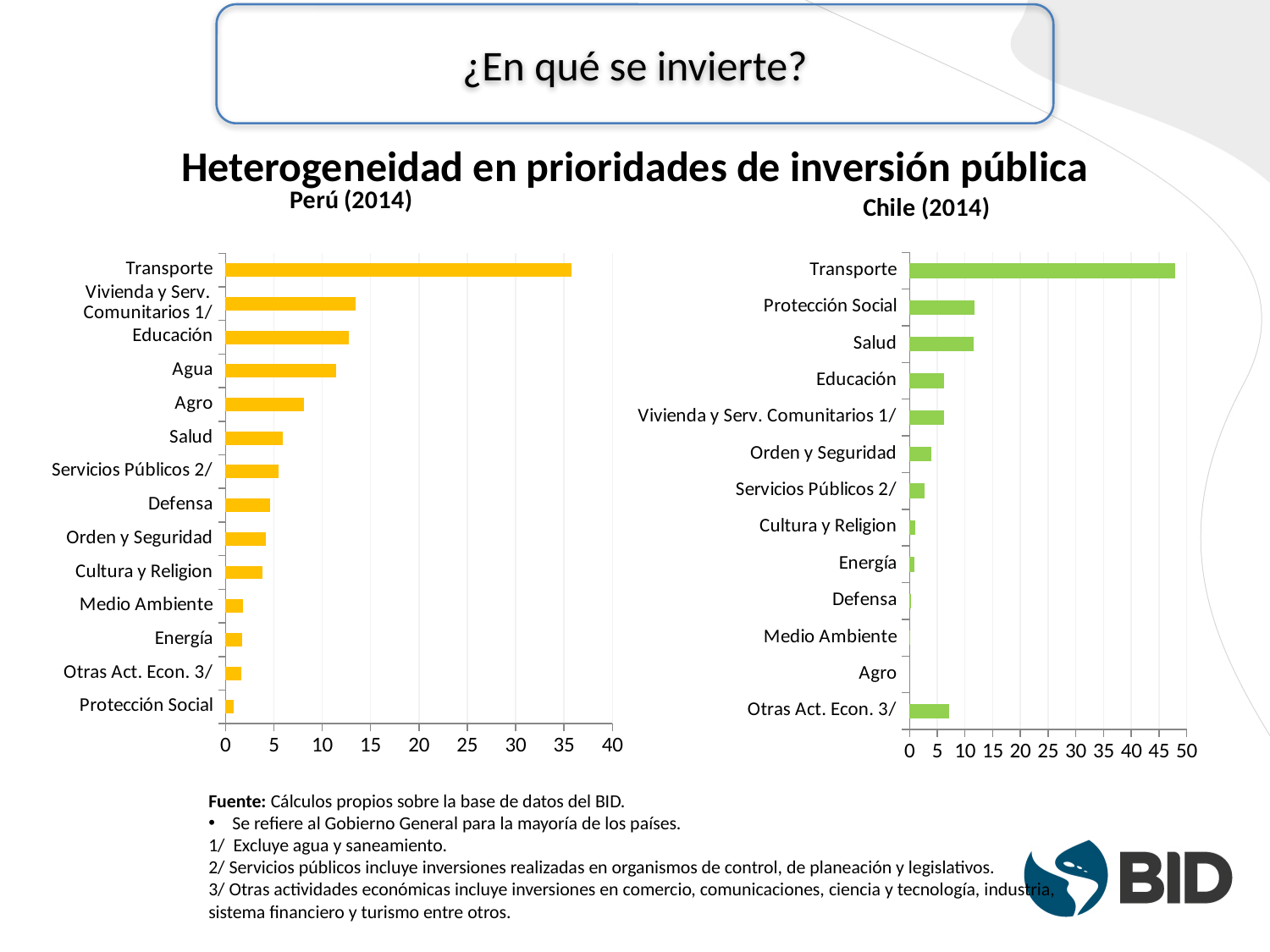
In the Perú (2014) chart, which category has the lowest value? Protección Social In the Perú (2014) chart, is the value for Transporte greater or less than 30? greater In the Chile (2014) chart, which category has the highest value? Transporte In the Perú (2014) chart, is the value for Agro greater or less than 5? greater In the Chile (2014) chart, which is larger, Educación or Cultura y Religion? Educación In the Perú (2014) chart, which category has the highest value? Transporte In the Chile (2014) chart, is the value for Educación greater or less than 10? less How many categories are shown in the Perú (2014) chart? 14 In the Perú (2014) chart, which is larger, Agro or Salud? Agro What kind of chart is the Perú (2014) chart? bar chart